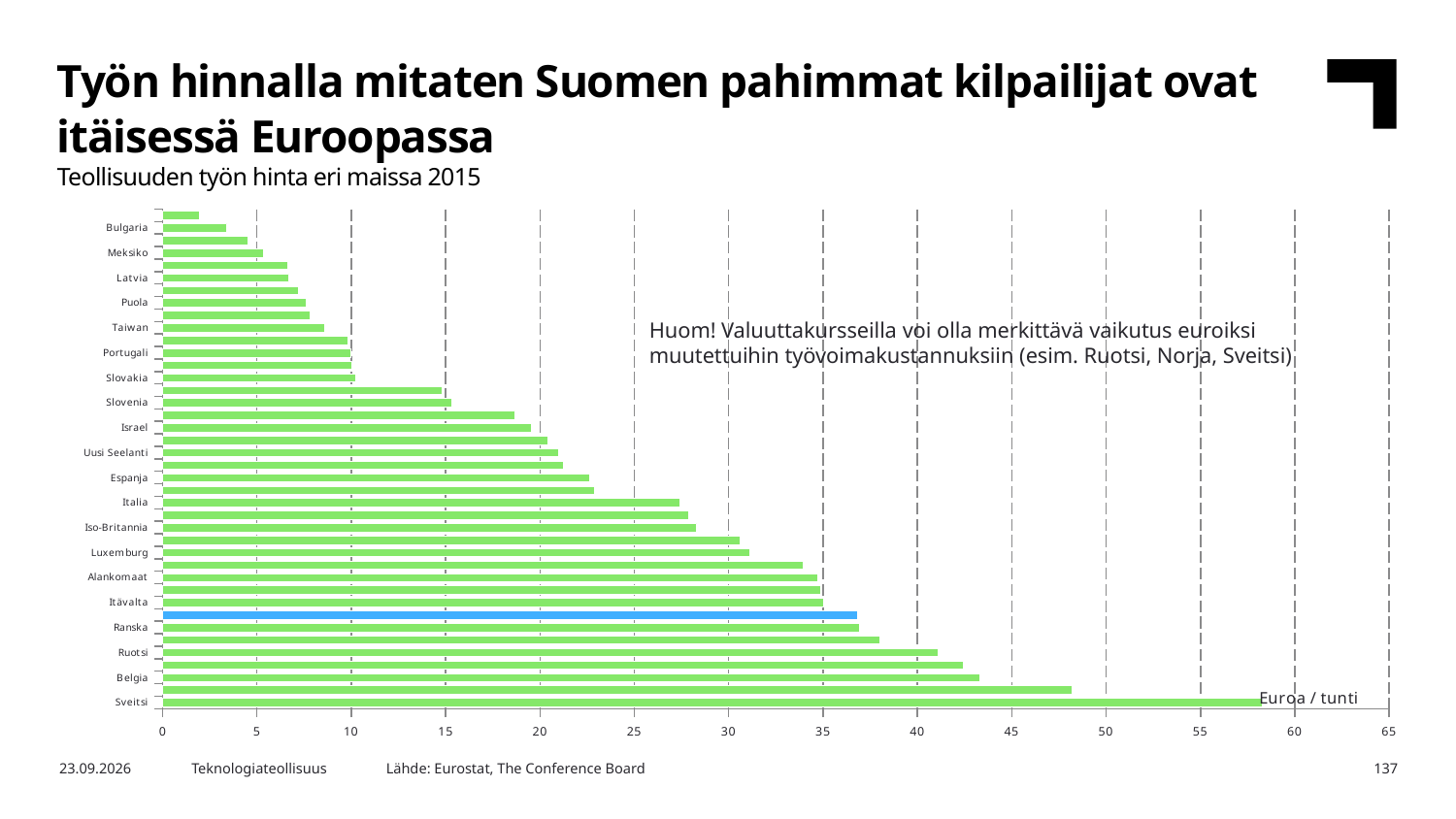
Is the value for Puola greater or less than 10? less Which country has the highest labour cost in the chart? Sveitsi What unit is shown for the values in the chart? Euroa / tunti Is the value for Belgia greater or less than 40? greater Is the value for Slovakia greater or less than 15? less Which has the higher value, Ruotsi or Italia? Ruotsi What is the subtitle of the chart? Teollisuuden työn hinta eri maissa 2015 What kind of chart is shown on the slide? bar chart Which has the higher value, Sveitsi or Belgia? Sveitsi